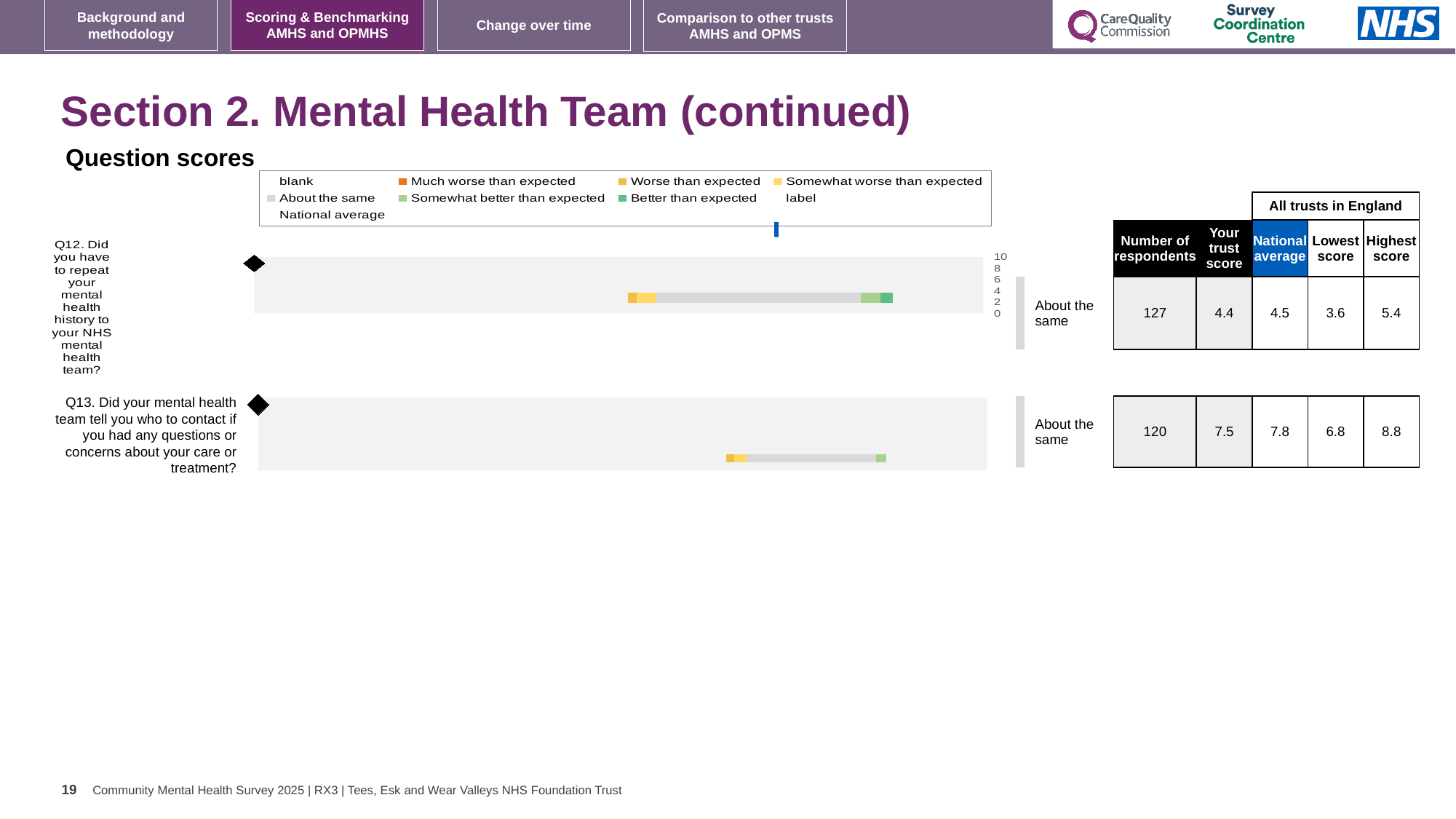
Which question has the higher trust score, Q12 or Q13? Q13 For Q13, which is larger: your trust score or the national average? National average What kind of chart is used to show the question scores on this slide? bar chart How many questions (Q12 and Q13) are plotted on the slide? 2 For Q13 (who to contact with questions or concerns), what is the lowest score among all trusts in England? 6.8 For Q12, what is the difference between the highest score (5.4) and the lowest score (3.6)? 1.8 For Q12 (repeating your mental health history), what is the number of respondents? 127 For Q12 (repeating your mental health history), what is the national average? 4.5 For Q13 (who to contact with questions or concerns), what is the highest score among all trusts in England? 8.8 For Q13, what is the difference between the national average (7.8) and your trust score (7.5)? 0.3 For Q12 (repeating your mental health history), what is your trust score? 4.4 What benchmark category label is shown next to the Q12 bar? About the same